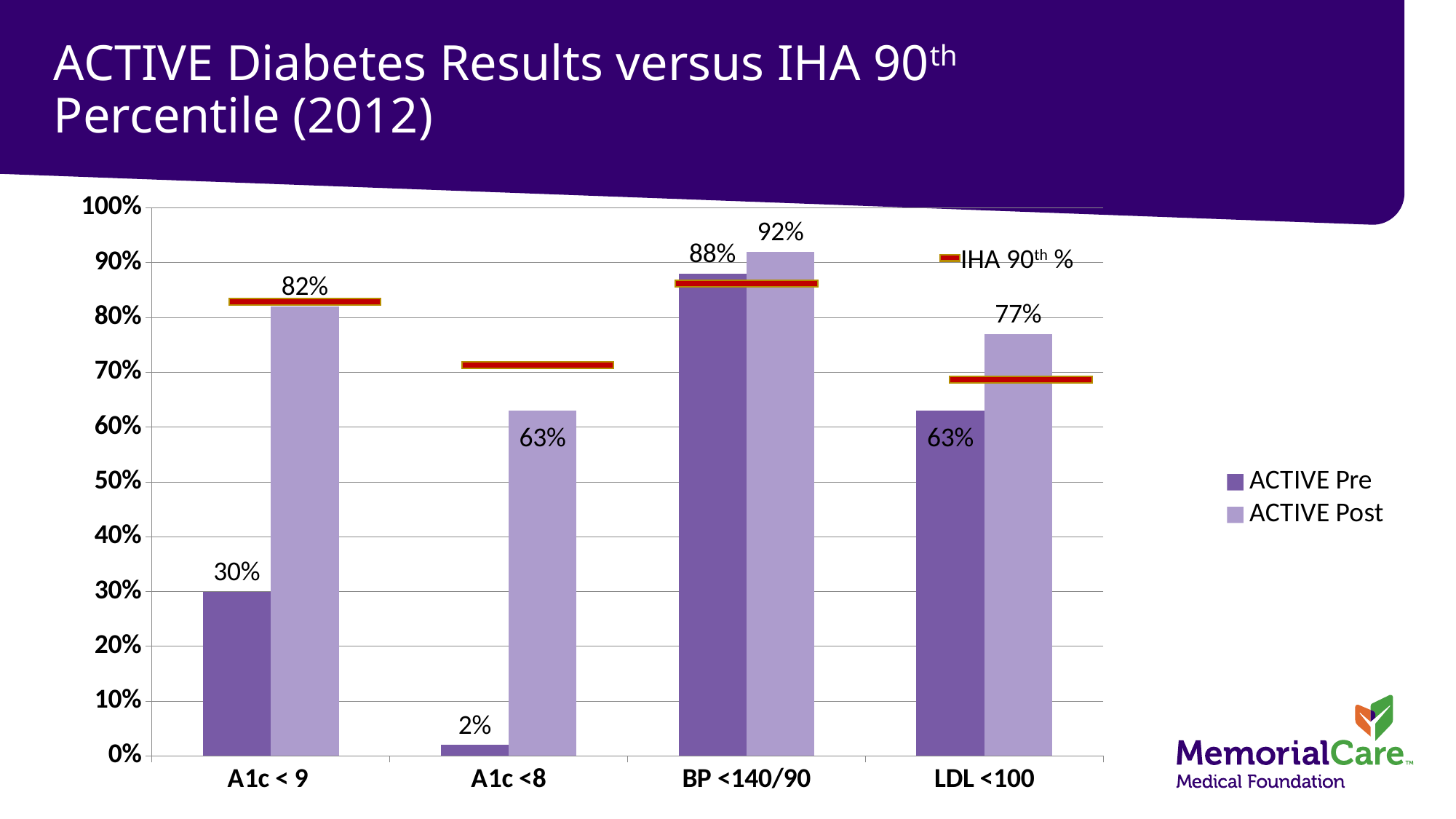
What is the ACTIVE Post value for BP <140/90? 92% What is the difference between the ACTIVE Post and ACTIVE Pre values for A1c < 9? 52% What is the ACTIVE Post value for A1c < 9? 82% Which category has the highest ACTIVE Post value? BP <140/90 What colour are the IHA 90th % marker lines? red What is the ACTIVE Pre value for A1c <8? 2% Which is larger: the ACTIVE Pre value for BP <140/90 or the ACTIVE Post value for LDL <100? ACTIVE Pre value for BP <140/90 Which category has the lowest ACTIVE Pre value? A1c <8 How many categories are shown on the x axis? 4 What is the ACTIVE Pre value for LDL <100? 63% What kind of chart is shown on the slide? bar chart